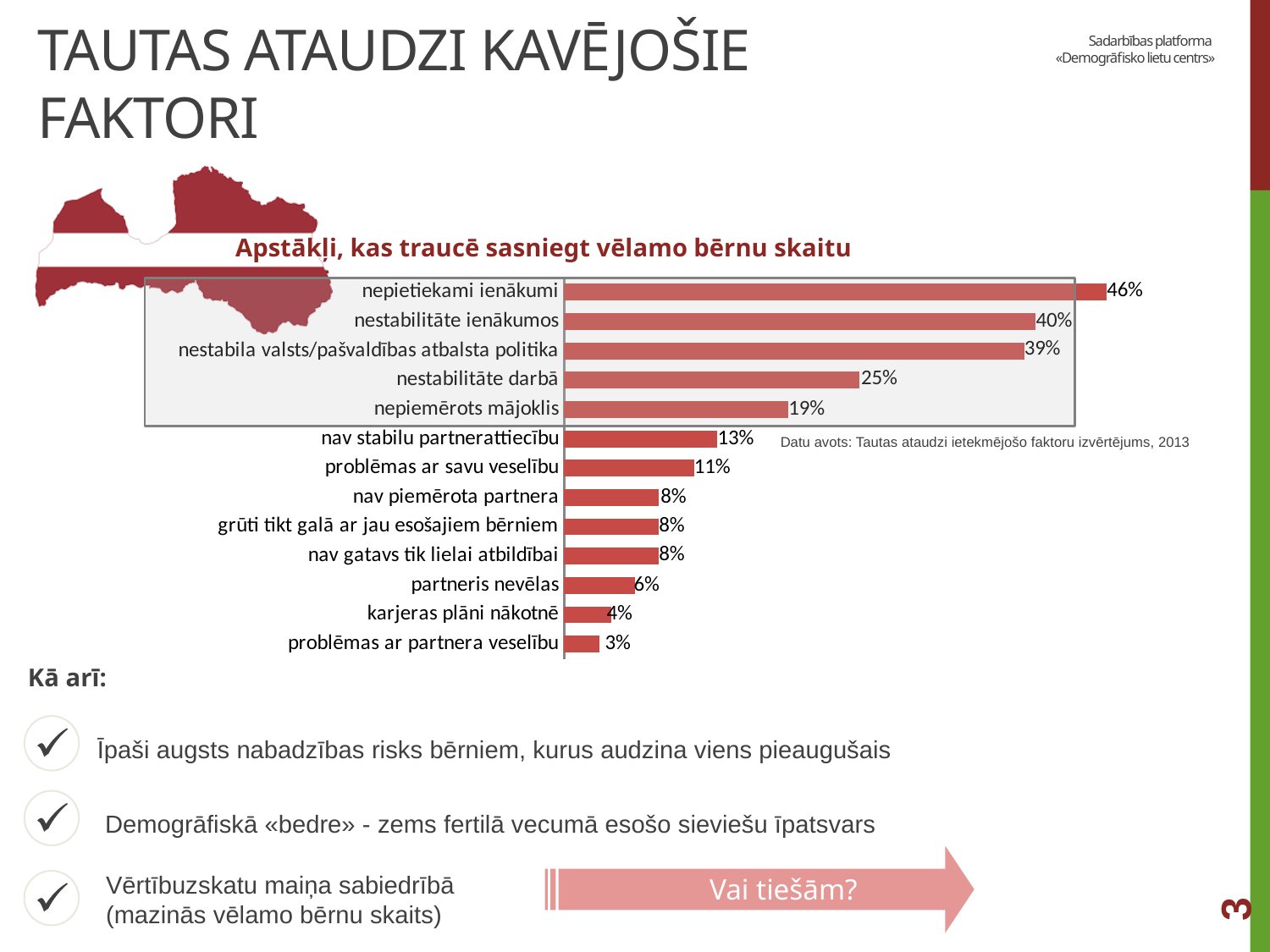
What is the value for 'nestabilitāte darbā'? 25% What is the difference between 'nepietiekami ienākumi' and 'nav stabilu partnerattiecību'? 33% What is the value for 'nepiemērots mājoklis'? 19% How many categories are shown in the chart? 13 What is the title of the chart? Apstākļi, kas traucē sasniegt vēlamo bērnu skaitu Which category has the lowest value? problēmas ar partnera veselību Which is larger: 'problēmas ar savu veselību' or 'partneris nevēlas'? problēmas ar savu veselību What is the value for 'karjeras plāni nākotnē'? 4% What is the value for 'nepietiekami ienākumi'? 46% What is the difference between 'nestabilitāte ienākumos' and 'nestabila valsts/pašvaldības atbalsta politika'? 1% What kind of chart is shown on the slide? bar chart Which category has the highest value? nepietiekami ienākumi